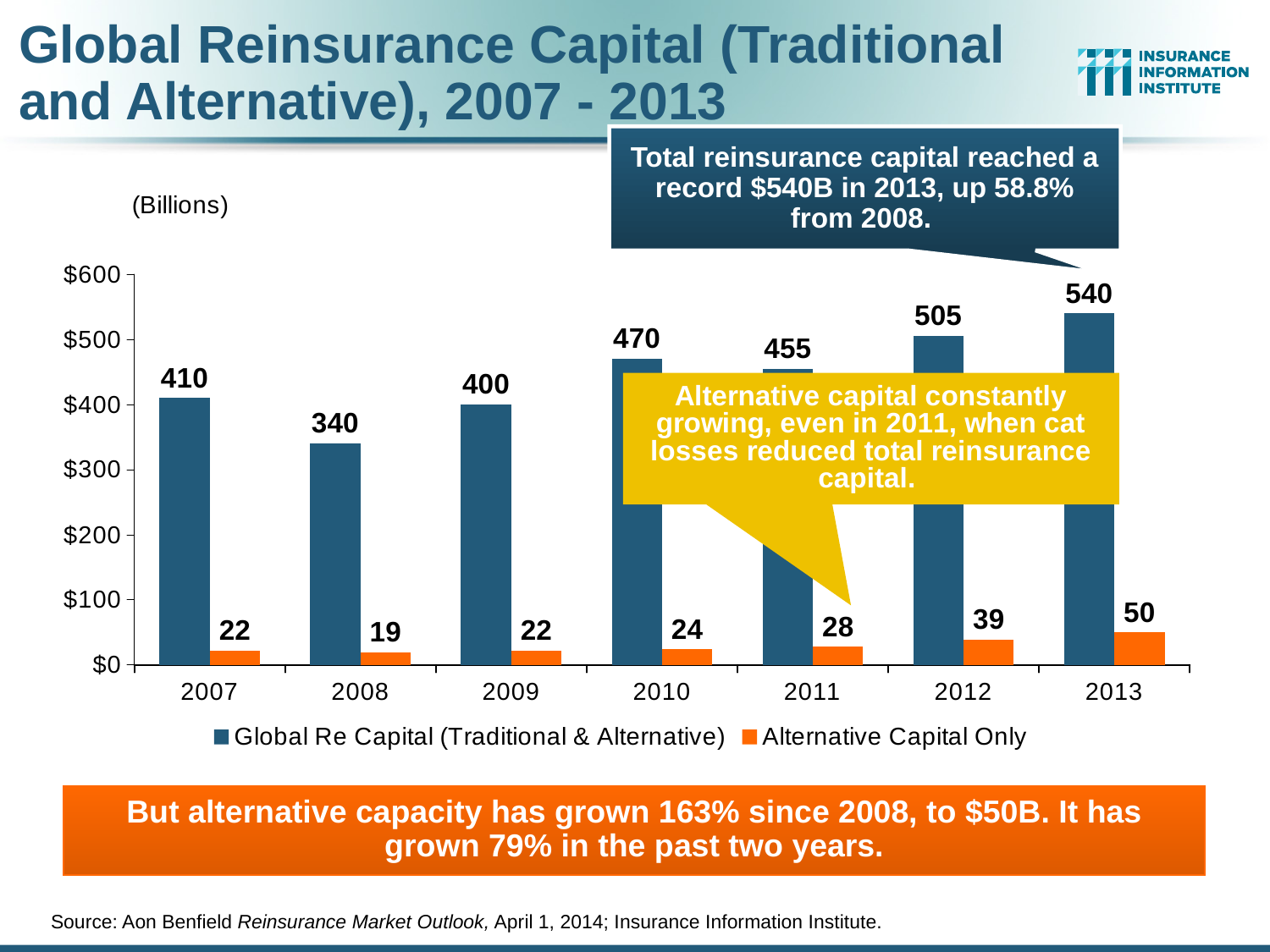
What is the value of Alternative Capital Only for 2008? 19 What is the value of Global Re Capital (Traditional & Alternative) for 2013? 540 Which is larger, Global Re Capital (Traditional & Alternative) in 2010 or in 2011? 2010 Which year has the highest value for Alternative Capital Only? 2013 What is the difference between Alternative Capital Only in 2013 and in 2012? 11 What kind of chart is shown on the slide? Bar chart How many years are shown on the x axis of the chart? 7 Does Alternative Capital Only rise or fall from 2009 to 2013? Rise How many series does the legend list? 2 Which year has the lowest value for Global Re Capital (Traditional & Alternative)? 2008 What is the value of Global Re Capital (Traditional & Alternative) for 2011? 455 What is the difference between Global Re Capital (Traditional & Alternative) in 2013 and in 2008? 200